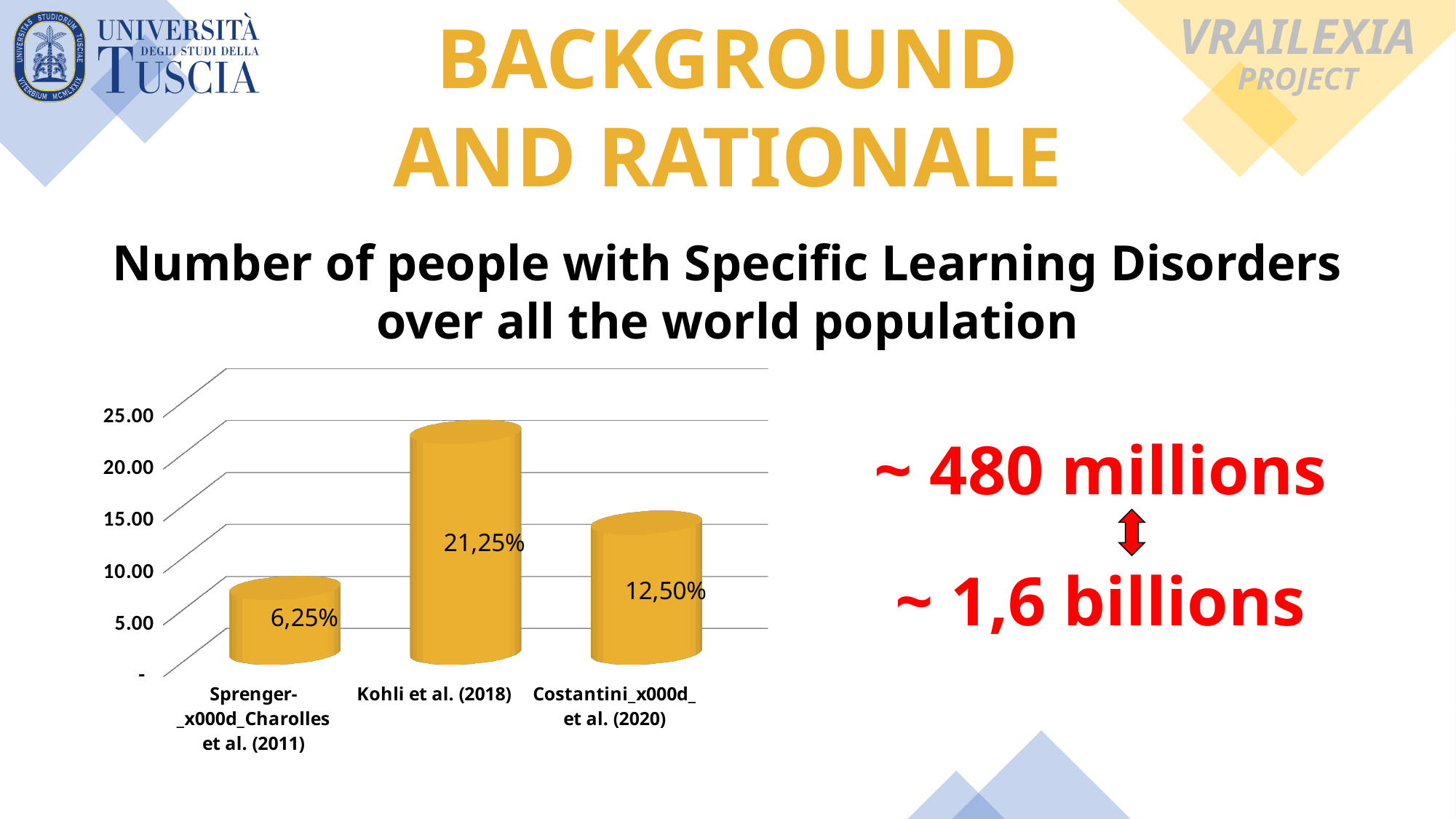
What value is shown for Kohli et al. (2018)? 21,25% What value is shown for Costantini et al. (2020)? 12,50% Which is larger, the value for Costantini et al. (2020) or the value for Sprenger-Charolles et al. (2011)? Costantini et al. (2020) What is the title of the chart? Number of people with Specific Learning Disorders over all the world population How many studies (bars) are shown in the chart? 3 What kind of chart is shown on the slide? Bar chart Which study reports the highest value? Kohli et al. (2018) What is the difference between the values for Kohli et al. (2018) and Sprenger-Charolles et al. (2011)? 15,00% Is the value for Kohli et al. (2018) greater or less than 20.00? greater What value is shown for Sprenger-Charolles et al. (2011)? 6,25% What is the difference between the values for Kohli et al. (2018) and Costantini et al. (2020)? 8,75% Which study reports the lowest value? Sprenger-Charolles et al. (2011)